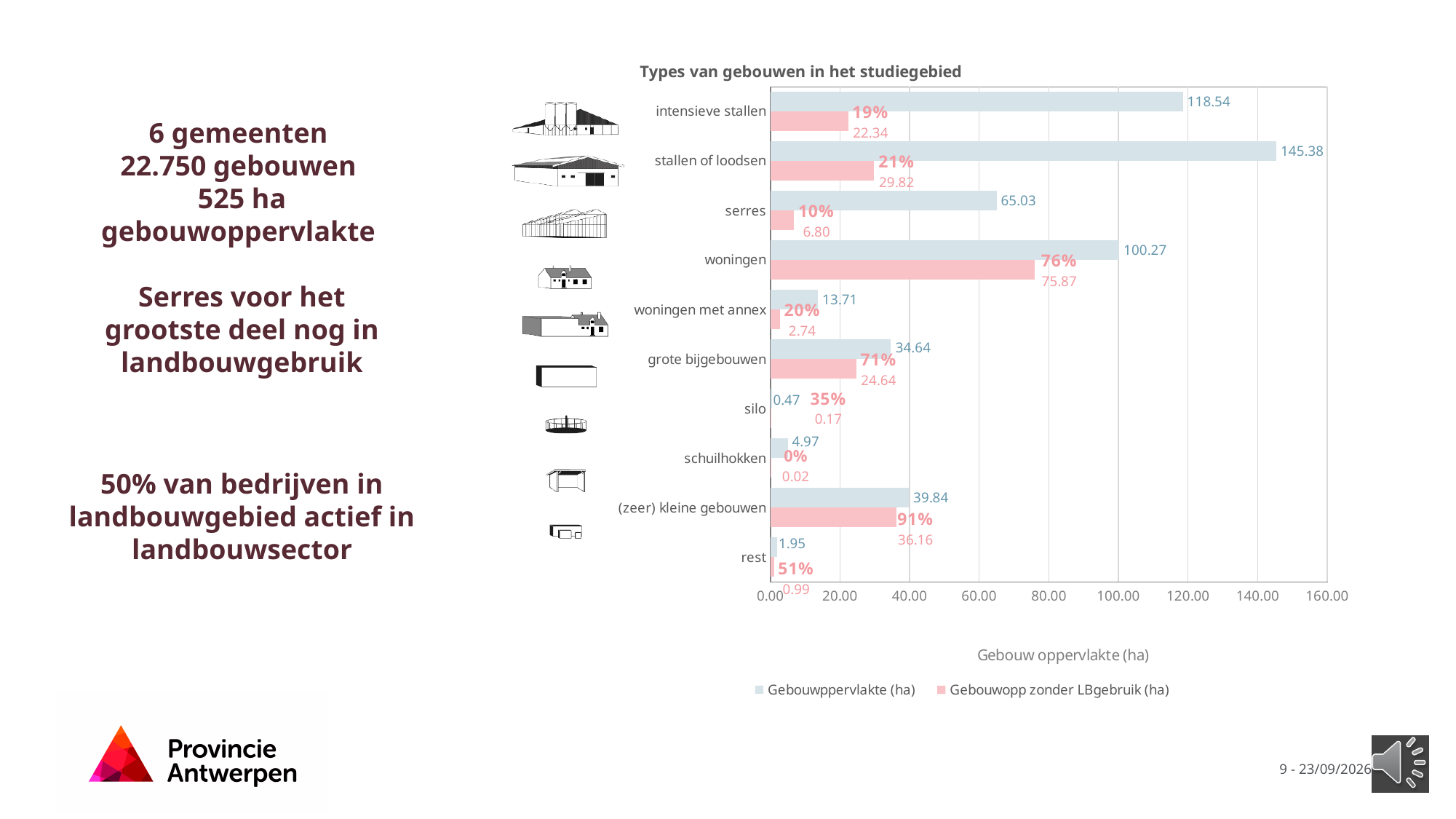
What is the difference between the Gebouwppervlakte (ha) of intensieve stallen and serres? 53.51 What is the Gebouwppervlakte (ha) value for stallen of loodsen? 145.38 How many building types (categories) are shown on the chart? 10 Which category has the highest Gebouwppervlakte (ha)? stallen of loodsen What is the title of the chart? Types van gebouwen in het studiegebied Which category has the lowest Gebouwopp zonder LBgebruik (ha)? schuilhokken Which is larger: the Gebouwppervlakte (ha) of woningen or of intensieve stallen? intensieve stallen What is the Gebouwopp zonder LBgebruik (ha) value for woningen? 75.87 Is the Gebouwppervlakte (ha) value for grote bijgebouwen greater or less than 40.00? less What percentage label is shown for (zeer) kleine gebouwen? 91% How many series does the legend list? 2 What kind of chart is shown on the slide? bar chart